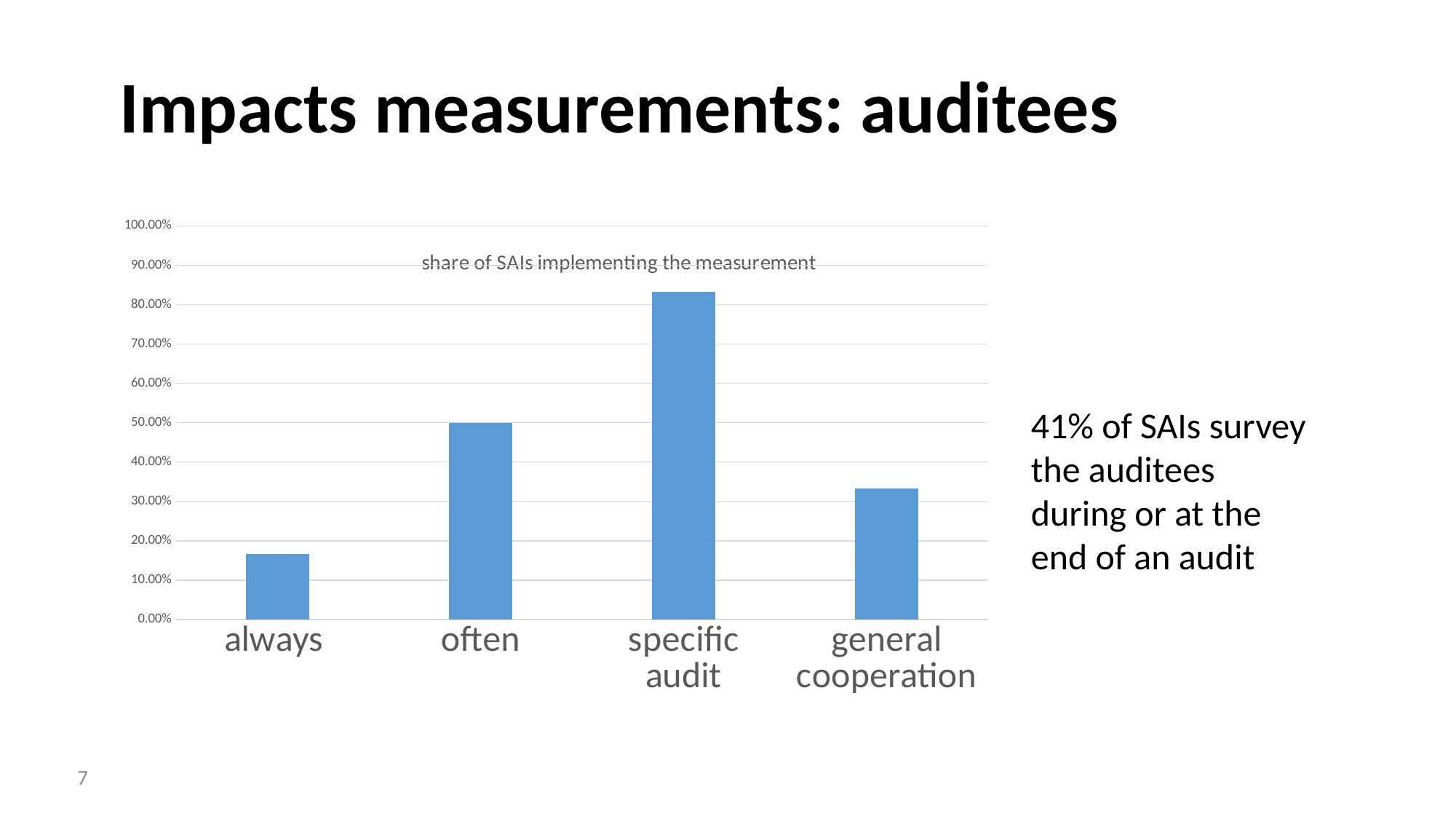
What kind of chart is shown on the slide? bar chart Which category has the highest value? specific audit What is the value for "often"? 50.00% Which is larger, the value for "always" or the value for "specific audit"? specific audit Is the value for "general cooperation" greater or less than 30.00%? greater How many categories are shown on the x axis of the chart? 4 Is the value for "specific audit" greater or less than 80.00%? greater Is the value for "general cooperation" greater or less than 40.00%? less Which category has the lowest value? always What is the title of the chart? share of SAIs implementing the measurement Which is larger, the value for "often" or the value for "general cooperation"? often